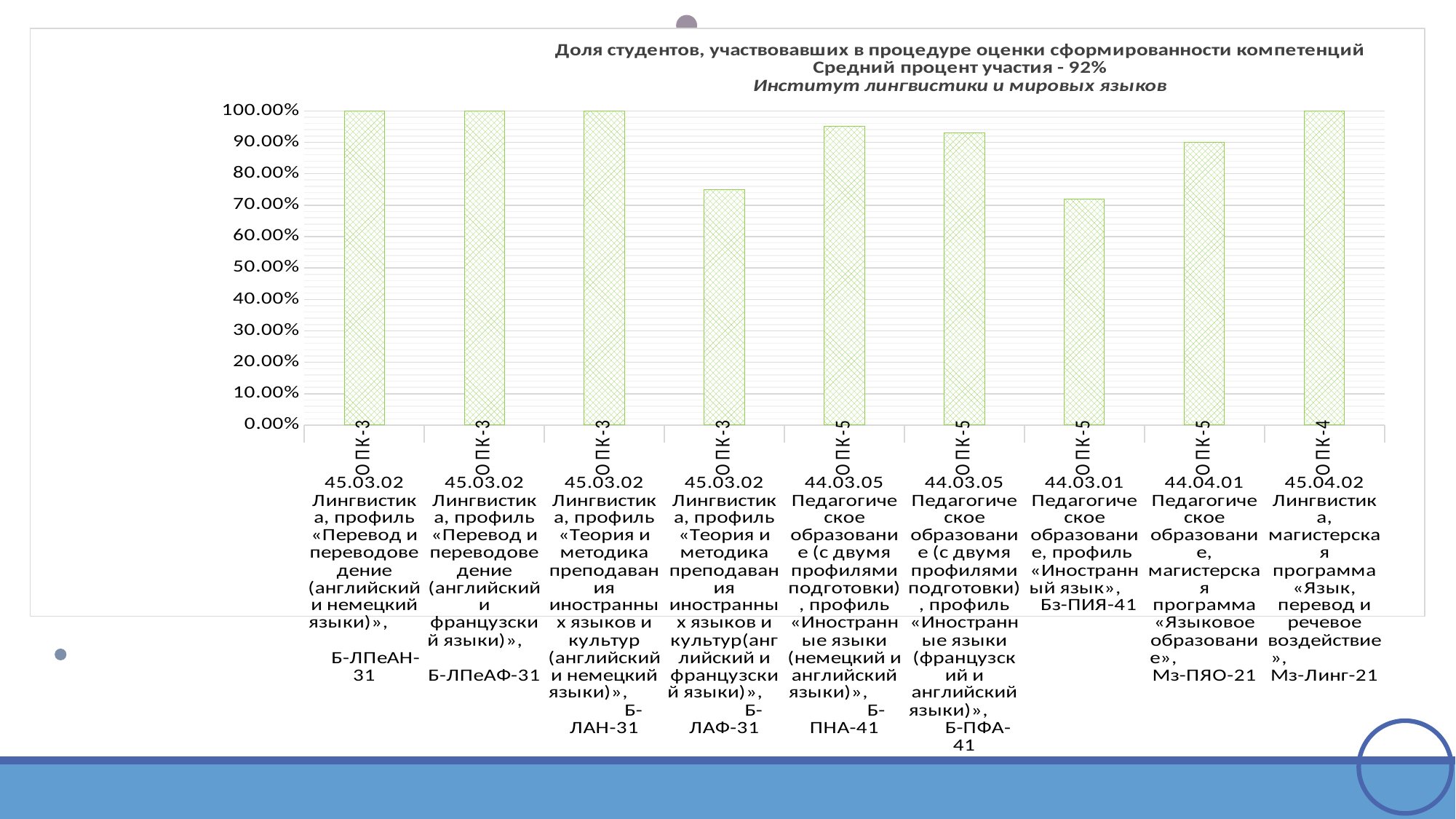
What kind of chart is shown on the slide? bar chart What is the share of students for group Мз-Линг-21? 100.00% Is the value for Бз-ПИЯ-41 greater or less than 80.00%? less How many groups reach 100.00% in the chart? 4 Which group has the larger value, Б-ПНА-41 or Б-ЛАФ-31? Б-ПНА-41 What average participation percentage is stated in the chart title? 92% What is the share of students for group Б-ЛПеАН-31? 100.00% Which group has the larger value, Б-ЛПеАФ-31 or Бз-ПИЯ-41? Б-ЛПеАФ-31 Is the value for Б-ЛАФ-31 greater or less than 80.00%? less How many groups (bars) are plotted in the chart? 9 Is the value for Б-ПФА-41 greater or less than 80.00%? greater